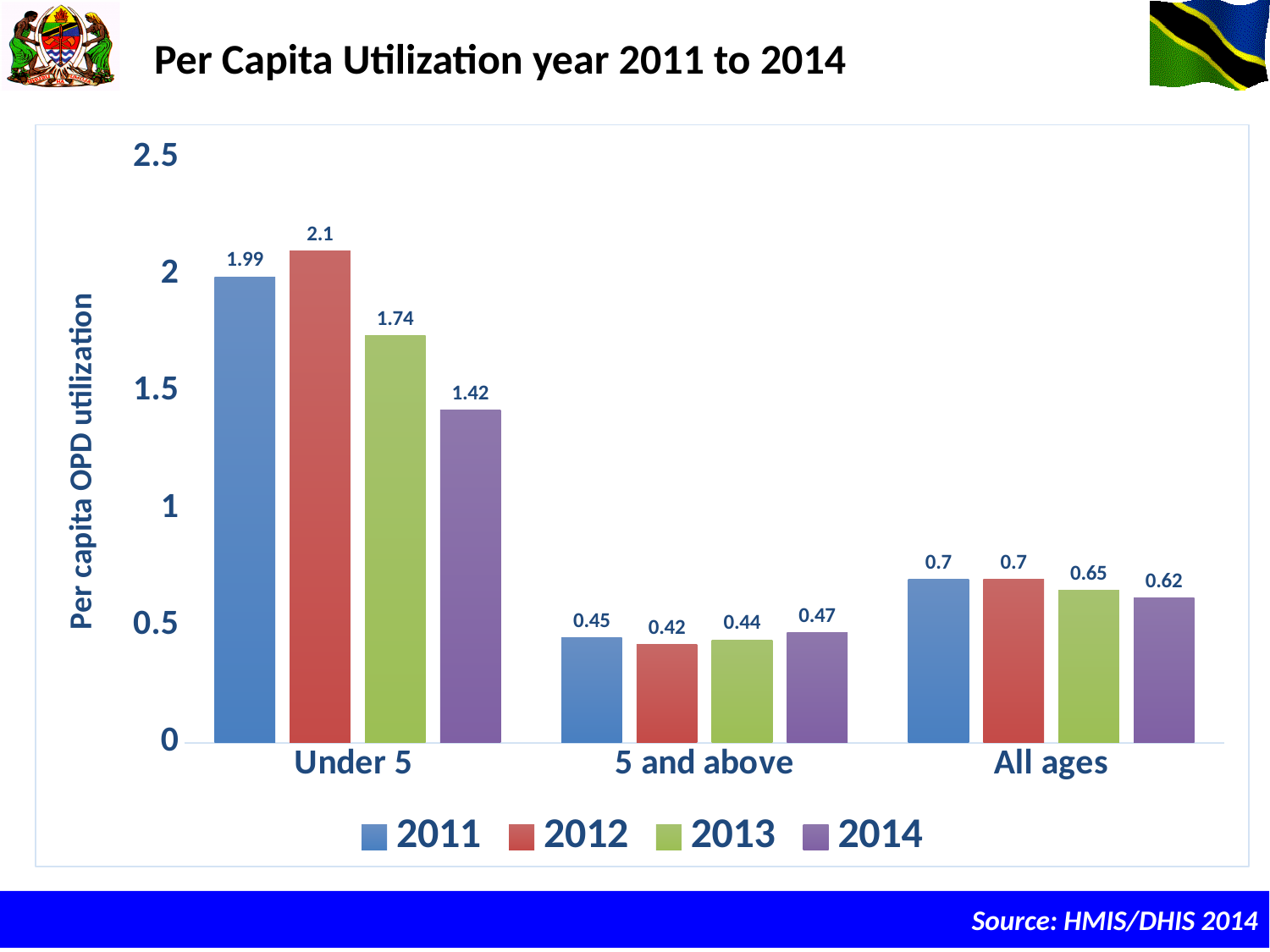
How many series does the legend list? 4 Which is larger, the All ages value for 2013 or for 2014? 2013 What is the label of the vertical axis? Per capita OPD utilization Which year has the lowest per capita OPD utilization for 5 and above? 2012 Do the Under 5 values rise or fall from 2012 to 2014? fall What is the per capita OPD utilization for All ages in 2013? 0.65 What is the per capita OPD utilization for Under 5 in 2012? 2.1 What is the difference between the Under 5 values for 2011 and 2014? 0.57 What kind of chart is shown on the slide? bar chart Which year has the highest per capita OPD utilization for Under 5? 2012 What is the per capita OPD utilization for 5 and above in 2014? 0.47 How many age categories are shown on the x axis? 3